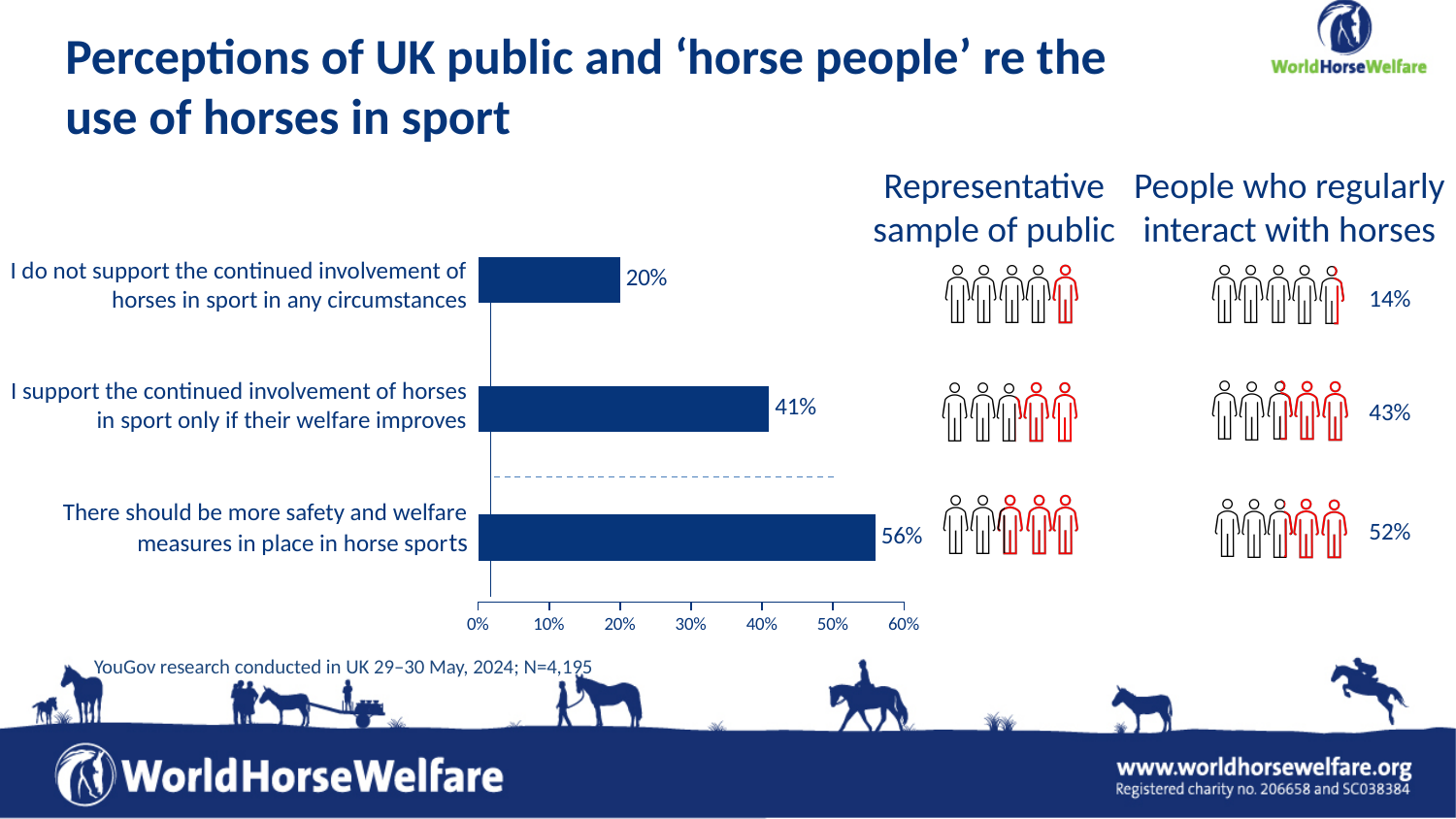
What kind of chart is shown on the slide? bar chart Is the value for 'I support the continued involvement of horses in sport only if their welfare improves' in the bar chart greater or less than 50%? less What is the value for 'There should be more safety and welfare measures in place in horse sports' in the bar chart? 56% What is the difference between the values for 'There should be more safety and welfare measures in place in horse sports' and 'I support the continued involvement of horses in sport only if their welfare improves' in the bar chart? 15% Which category has the lowest value in the bar chart? I do not support the continued involvement of horses in sport in any circumstances What is the value for 'I support the continued involvement of horses in sport only if their welfare improves' in the bar chart? 41% In the 'People who regularly interact with horses' pictogram column, what is the value for 'There should be more safety and welfare measures in place in horse sports'? 52% What is the value for 'I do not support the continued involvement of horses in sport in any circumstances' in the bar chart? 20% In the bar chart, which is larger: the value for 'I support the continued involvement of horses in sport only if their welfare improves' or the value for 'I do not support the continued involvement of horses in sport in any circumstances'? I support the continued involvement of horses in sport only if their welfare improves How many categories does the bar chart show? 3 What is the maximum value shown on the x axis of the bar chart? 60% Which category has the highest value in the bar chart? There should be more safety and welfare measures in place in horse sports